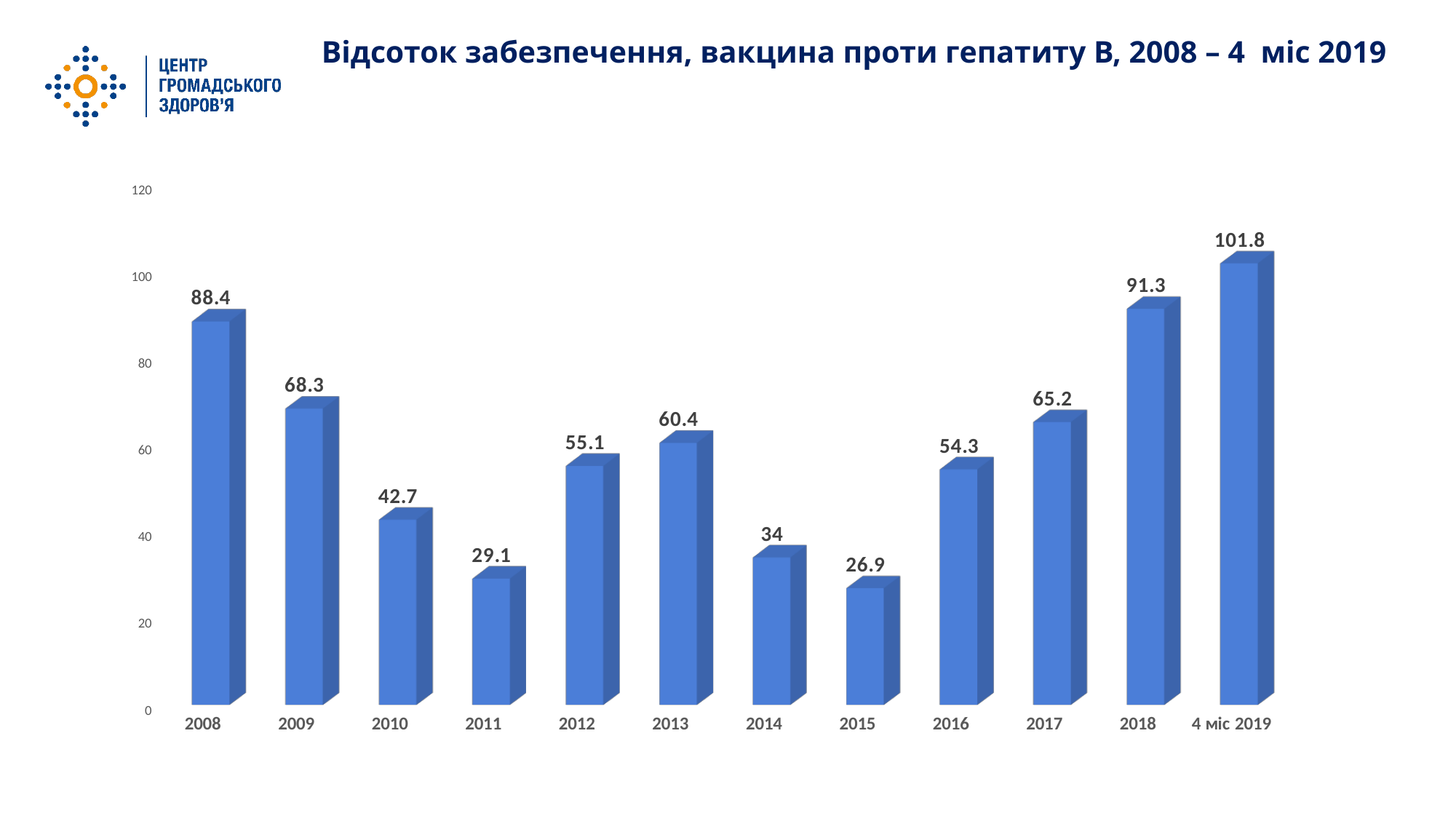
Which category has the lowest value? 2015 Do the values rise or fall from 2015 to 4 міс 2019? rise What is the difference between the values for 2018 and 2017? 26.1 Which is larger, the value for 2012 or the value for 2013? 2013 Which category has the highest value? 4 міс 2019 What is the title of the chart? Відсоток забезпечення, вакцина проти гепатиту В, 2008 – 4 міс 2019 What kind of chart is this? bar chart What is the value for 2015? 26.9 Is the value for 2011 greater or less than 40? less What is the value for 4 міс 2019? 101.8 How many categories are shown on the x axis? 12 What is the value for 2008? 88.4